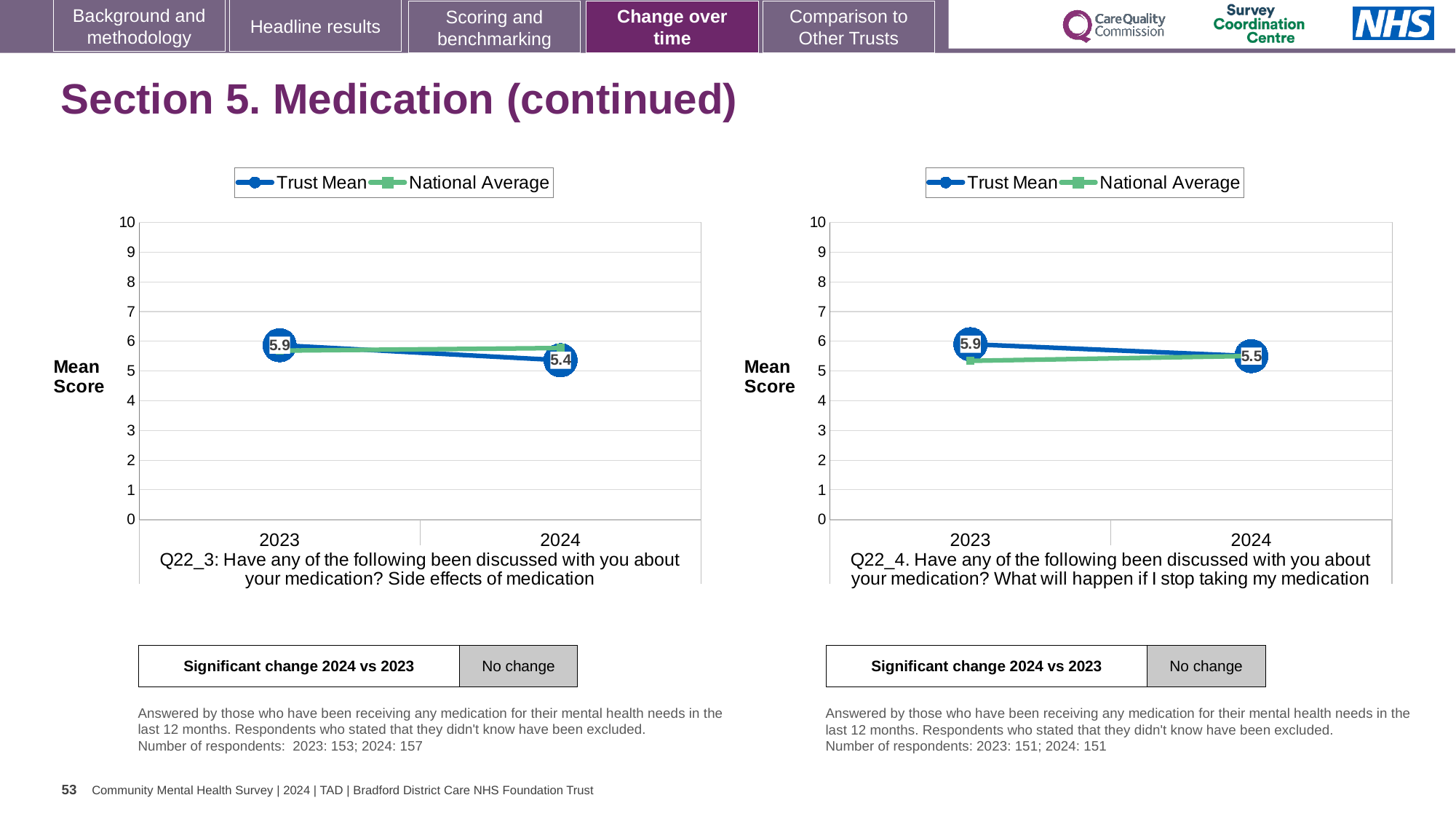
In the right chart (Q22_4), is the Trust Mean for 2023 greater or less than 5? greater What type of chart is used on the left side of the slide? line chart How many years are plotted on the x axis of the right chart? 2 How many series does the legend of the left chart list? 2 In the right chart (Q22_4), what is the Trust Mean for 2023? 5.9 In the right chart (Q22_4), what is the Trust Mean for 2024? 5.5 In the right chart (Q22_4), which is higher in 2023, the Trust Mean or the National Average? Trust Mean In the left chart (Q22_3), what is the Trust Mean for 2023? 5.9 In the left chart (Q22_3), by how much did the Trust Mean change from 2023 to 2024? 0.5 In the left chart (Q22_3), what is the Trust Mean for 2024? 5.4 In the right chart (Q22_4), what is the difference between the Trust Mean in 2023 and 2024? 0.4 In the left chart (Q22_3), does the Trust Mean rise or fall from 2023 to 2024? fall